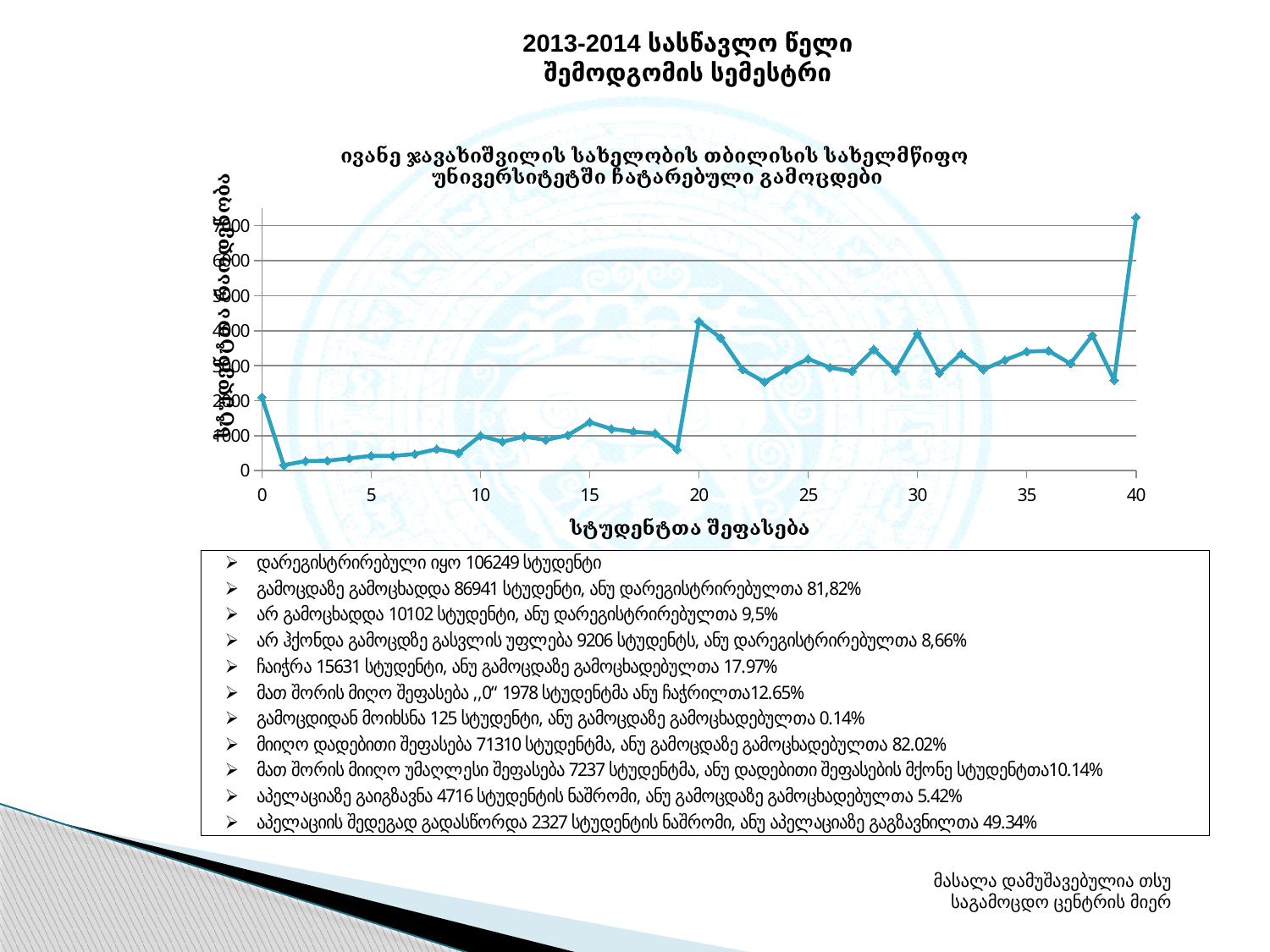
Is the value at grade 39 greater or less than 3000? less Does the line rise or fall between grade 0 and grade 1? falls Is the value at grade 30 greater or less than 3000? greater At which x-axis value (student grade) does the line reach its highest point? 40 What is the title of the x axis of the chart? სტუდენტთა შეფასება Is the value at grade 19 greater or less than 1000? less At which x-axis value (student grade) does the line reach its lowest point? 1 Which is larger: the value at grade 20 or the value at grade 0? grade 20 Which is larger: the value at grade 5 or the value at grade 25? grade 25 What kind of chart is shown on the slide? line chart